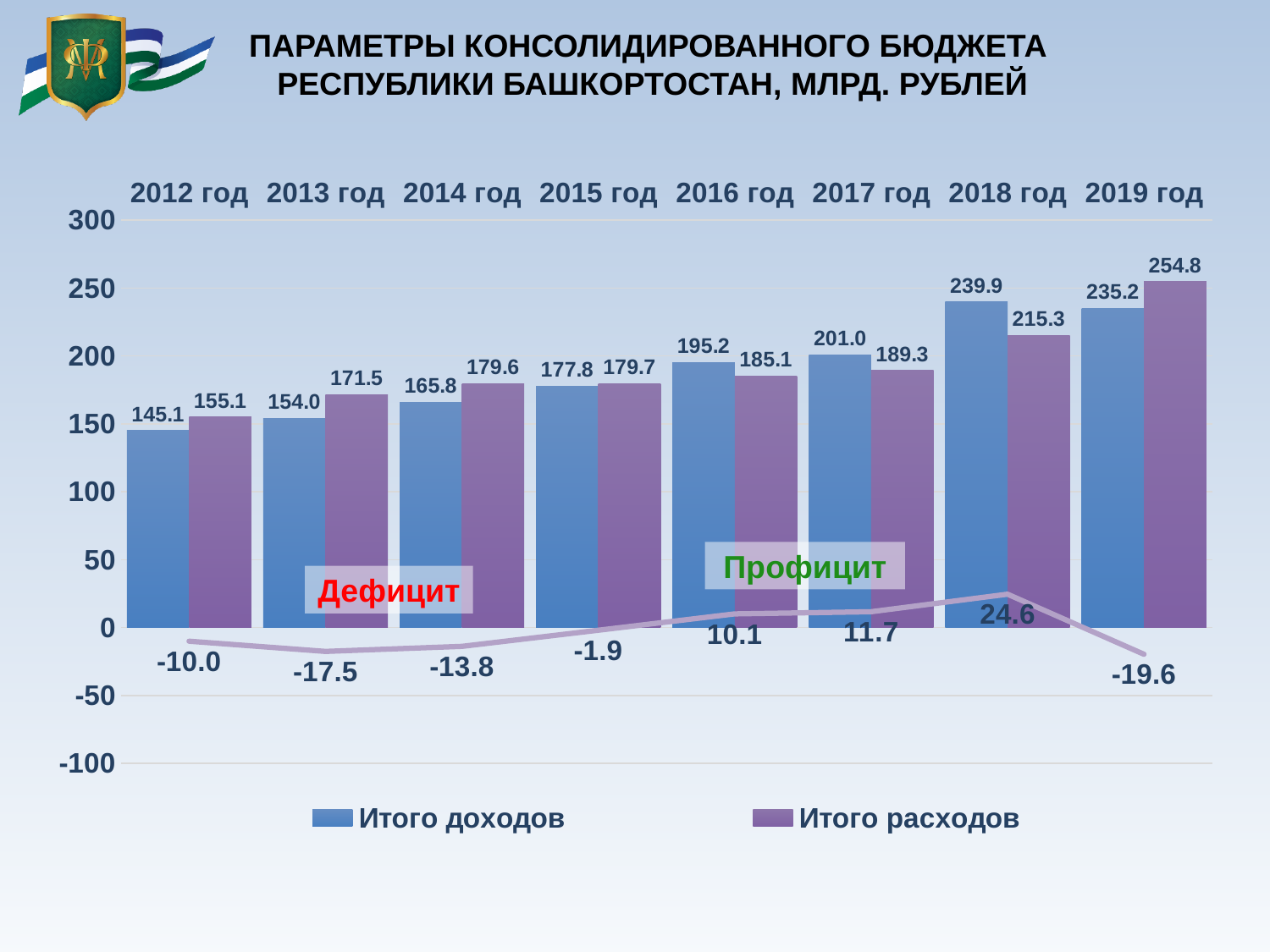
How many series does the legend list? 2 What kind of chart is this? Bar chart with a line In which year is Итого доходов the highest? 2018 год How many years are shown on the x axis? 8 Which is larger in 2018 год, Итого доходов or Итого расходов? Итого доходов What is the value of Итого расходов for 2013 год? 171.5 What is the value shown on the line for 2015 год? -1.9 What is the difference between Итого расходов and Итого доходов in 2019 год? 19.6 What is the value of Итого доходов for 2018 год? 239.9 In which year is Итого доходов the lowest? 2012 год What is the value of Итого расходов for 2019 год? 254.8 Does Итого расходов rise or fall from 2012 год to 2019 год? Rise